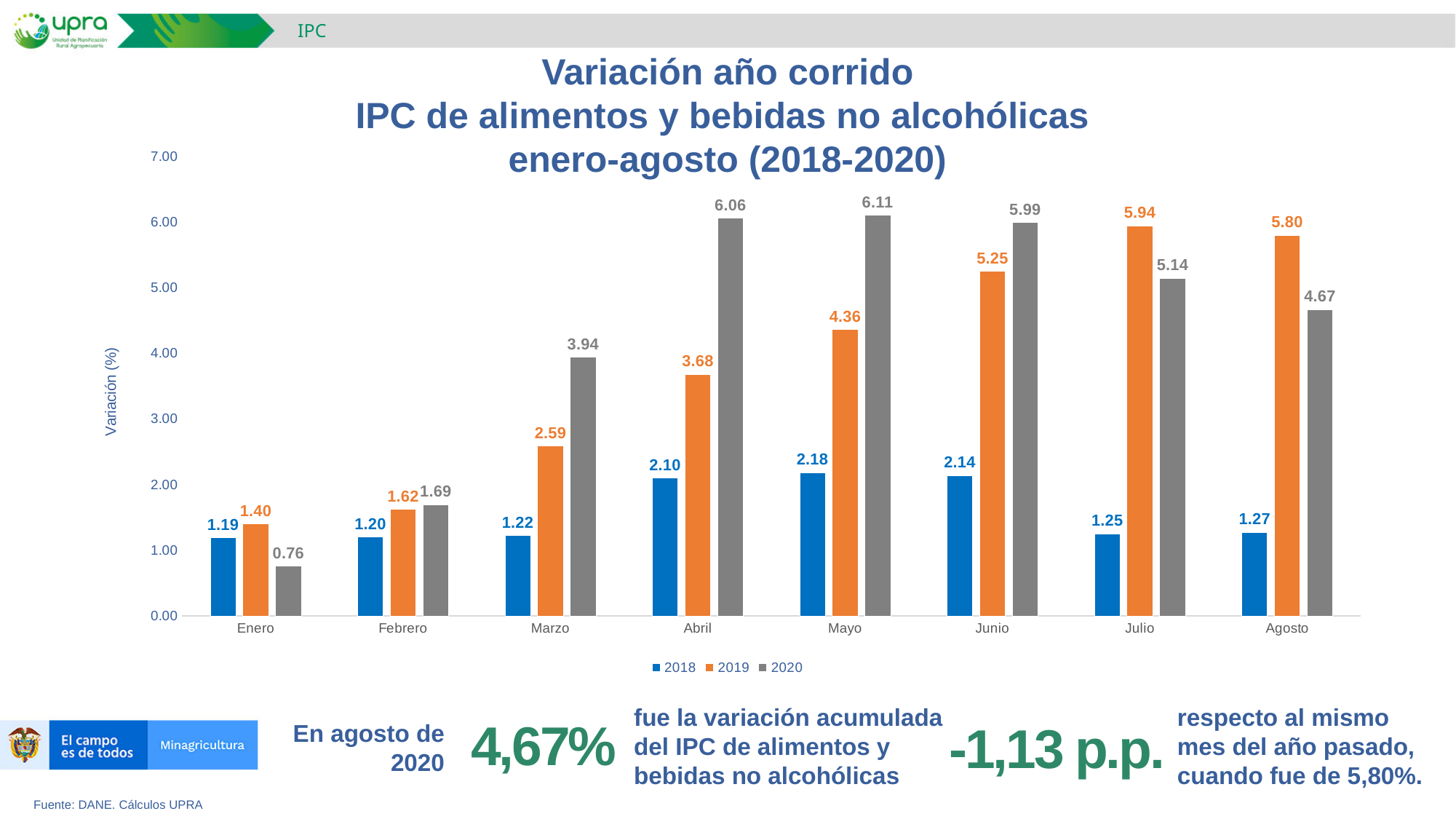
How many months are shown on the x axis? 8 What is the value for 2018 in Enero? 1.19 How many series does the legend list? 3 Which month has the highest value for the 2020 series? Mayo What is the label of the y axis? Variación (%) What is the value for 2020 in Abril? 6.06 What is the value for 2019 in Julio? 5.94 Which is larger in Julio, the 2019 value or the 2020 value? 2019 What kind of chart is shown on the slide? bar chart Which month has the lowest value for the 2020 series? Enero Is the value for 2019 in Mayo greater or less than 4.00? greater What is the difference between the 2019 and 2020 values in Agosto? 1.13